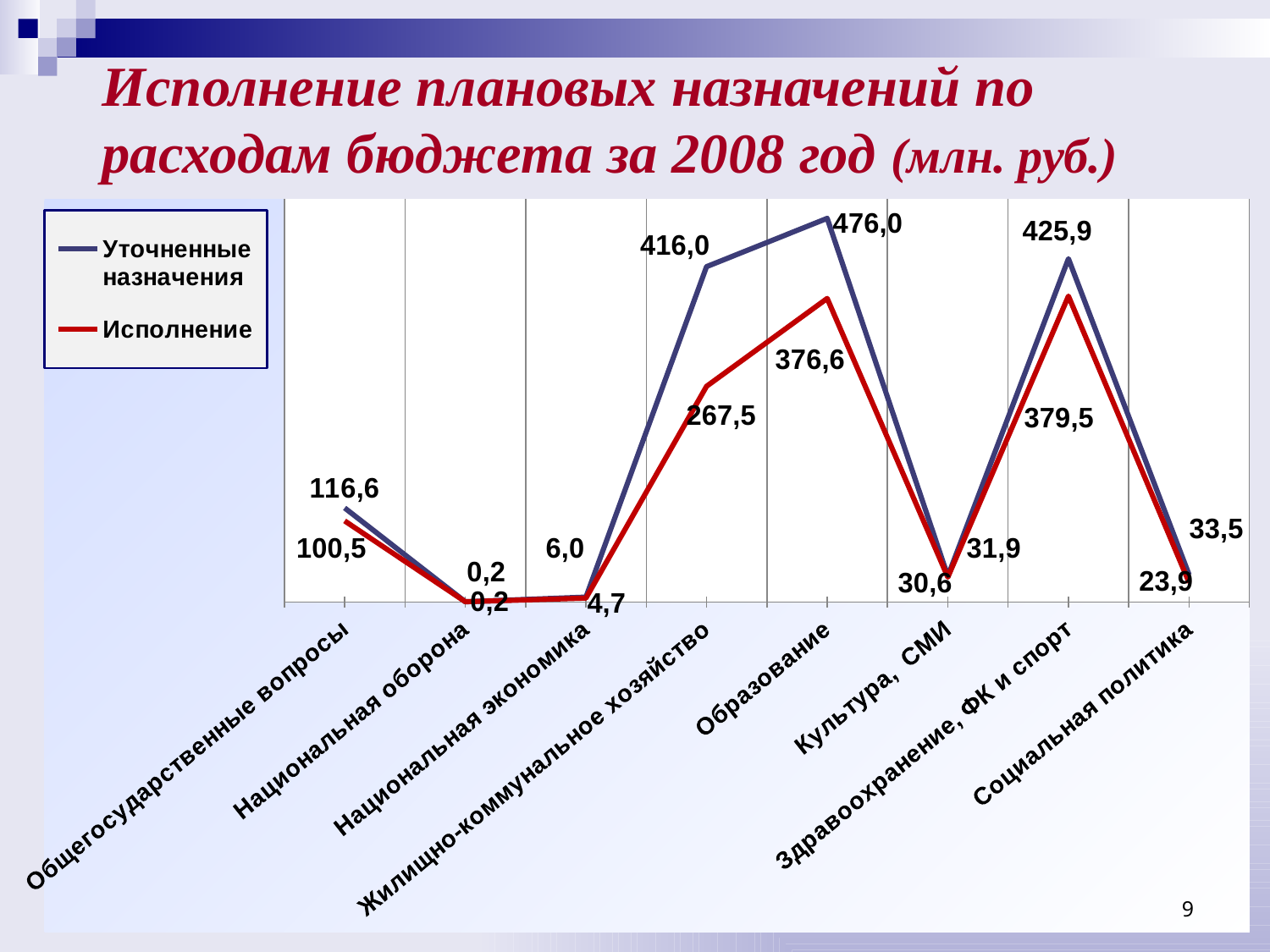
What is the value of Уточненные назначения for Образование? 476,0 How many series does the legend list? 2 What kind of chart is shown on the slide? Line chart What is the value of Исполнение for Социальная политика? 23,9 What is the value of Исполнение for Жилищно-коммунальное хозяйство? 267,5 What is the difference between Уточненные назначения and Исполнение for Жилищно-коммунальное хозяйство? 148,5 Which category has the highest value for Уточненные назначения? Образование Which colour is used for the Исполнение line? Red Which is larger for Здравоохранение, ФК и спорт: Уточненные назначения or Исполнение? Уточненные назначения What is the difference between Уточненные назначения and Исполнение for Образование? 99,4 How many categories are plotted along the x axis? 8 Which category has the lowest value for Исполнение? Национальная оборона